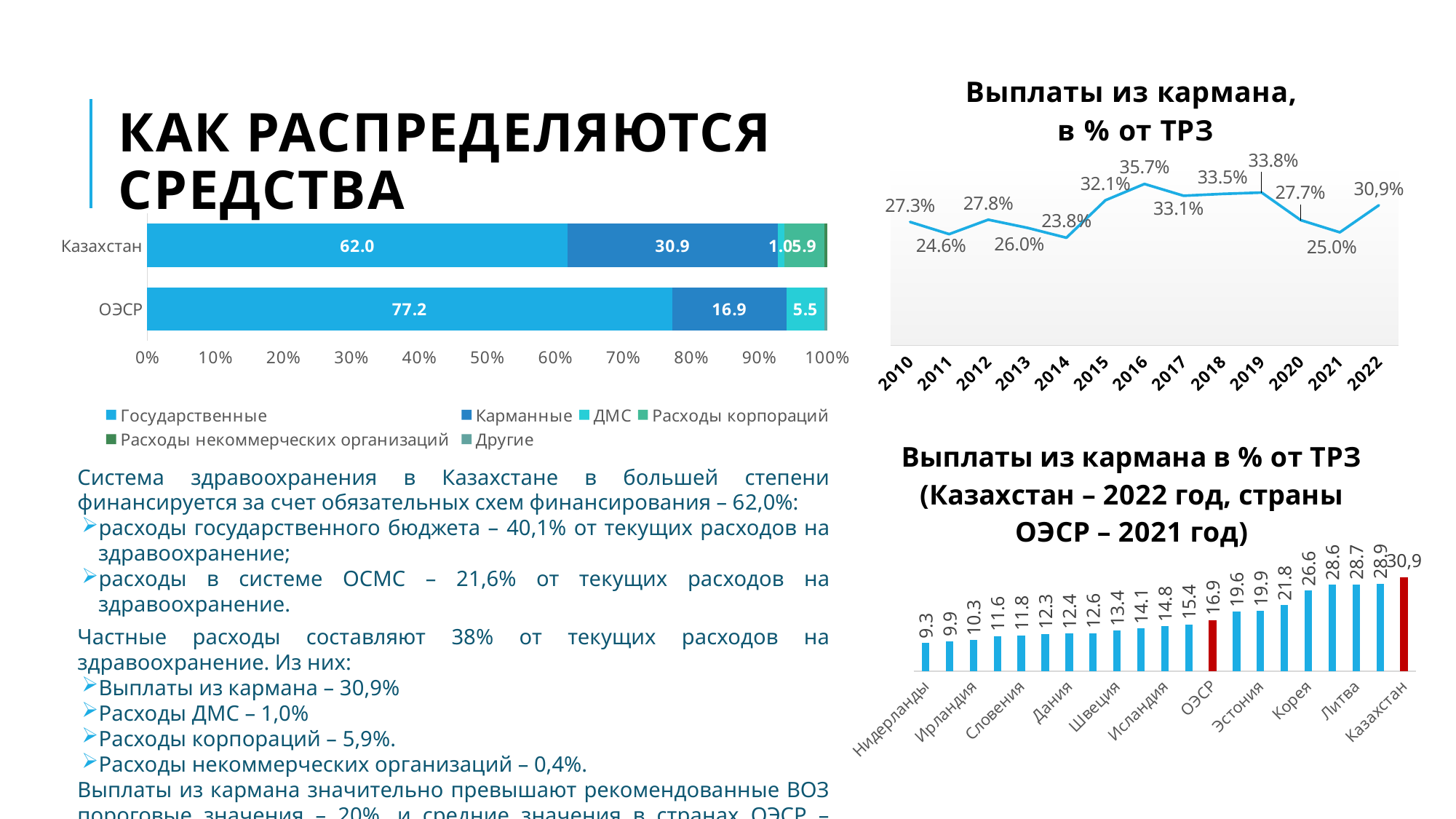
In the stacked bar chart on the left, what is the value of Государственные for Казахстан? 62.0 In the stacked bar chart on the left, what is the difference between the Государственные values for ОЭСР and Казахстан? 15.2 In the chart titled 'Выплаты из кармана, в % от ТРЗ', which year has the lowest value? 2014 In the chart titled 'Выплаты из кармана, в % от ТРЗ', how many years are plotted? 13 In the chart titled 'Выплаты из кармана, в % от ТРЗ', what is the value for 2016? 35.7% In the chart titled 'Выплаты из кармана в % от ТРЗ (Казахстан – 2022 год, страны ОЭСР – 2021 год)', which country has the highest value? Казахстан What kind of chart is 'Выплаты из кармана, в % от ТРЗ'? line chart In the stacked bar chart on the left, what is the value of Карманные for ОЭСР? 16.9 In the chart titled 'Выплаты из кармана в % от ТРЗ (Казахстан – 2022 год, страны ОЭСР – 2021 год)', what is the value for ОЭСР? 16.9 In the stacked bar chart on the left, how many series does the legend list? 6 In the chart titled 'Выплаты из кармана в % от ТРЗ (Казахстан – 2022 год, страны ОЭСР – 2021 год)', which is larger, Корея or Эстония? Корея In the chart titled 'Выплаты из кармана, в % от ТРЗ', do values rise or fall from 2019 to 2021? fall